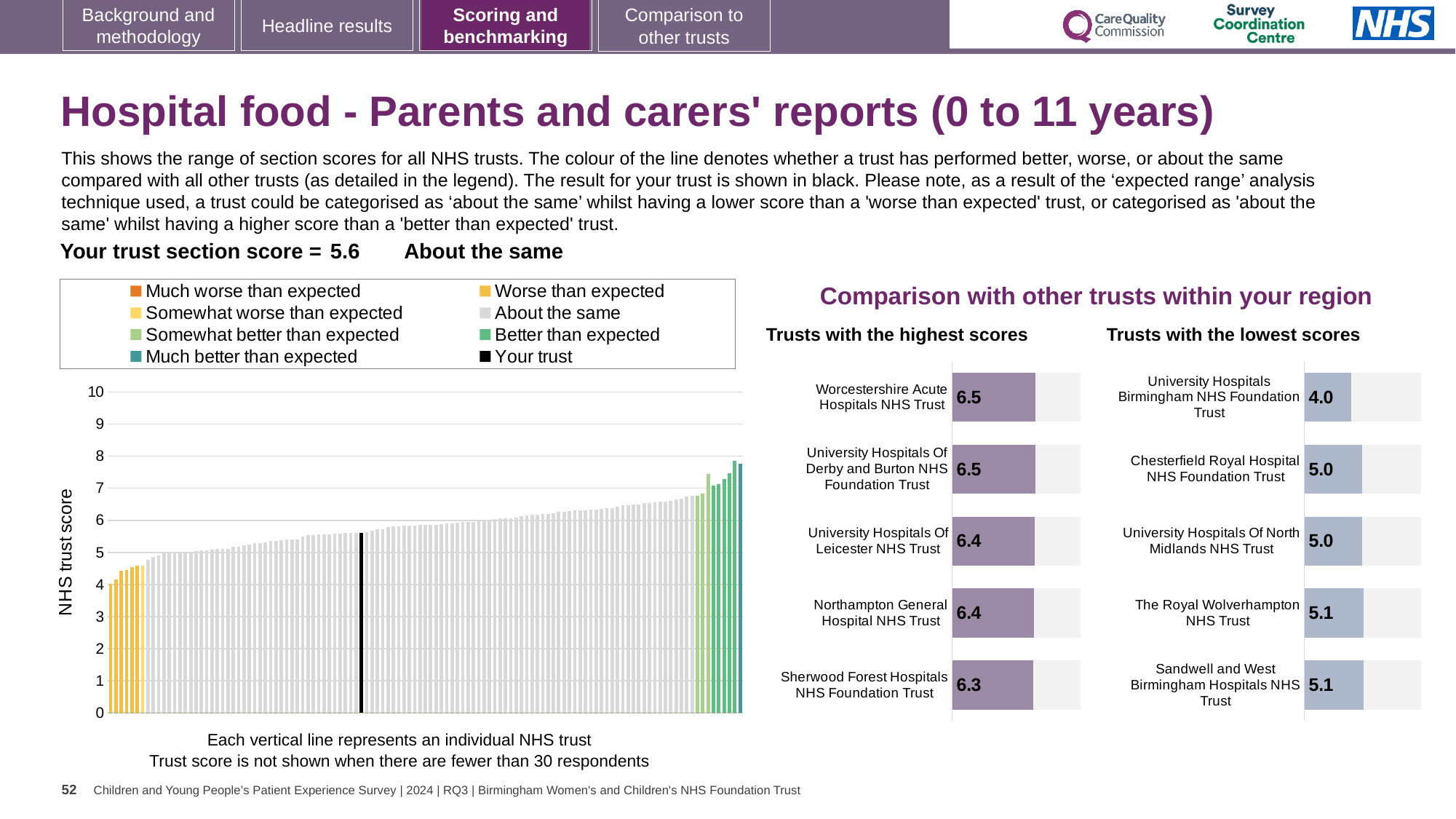
In the 'Trusts with the highest scores' chart, what is the score for Sherwood Forest Hospitals NHS Foundation Trust? 6.3 In the 'Trusts with the lowest scores' chart, what is the difference between the scores of Chesterfield Royal Hospital NHS Foundation Trust and University Hospitals Birmingham NHS Foundation Trust? 1.0 What kind of chart is the large chart on the left showing NHS trust scores? Bar chart In the 'Trusts with the lowest scores' chart, what is the score for The Royal Wolverhampton NHS Trust? 5.1 How many trusts are shown in the 'Trusts with the highest scores' chart? 5 Which has the higher score: University Hospitals Of Leicester NHS Trust in the highest scores chart, or Sandwell and West Birmingham Hospitals NHS Trust in the lowest scores chart? University Hospitals Of Leicester NHS Trust In the 'Trusts with the highest scores' chart, what is the score for Worcestershire Acute Hospitals NHS Trust? 6.5 In the large chart on the left, do the NHS trust scores rise or fall from left to right? Rise In the 'Trusts with the highest scores' chart, which trust has the lowest score? Sherwood Forest Hospitals NHS Foundation Trust In the 'Trusts with the highest scores' chart, what is the difference between the scores of Worcestershire Acute Hospitals NHS Trust and Sherwood Forest Hospitals NHS Foundation Trust? 0.2 In the 'Trusts with the lowest scores' chart, what is the score for University Hospitals Birmingham NHS Foundation Trust? 4.0 In the 'Trusts with the lowest scores' chart, which trust has the lowest score? University Hospitals Birmingham NHS Foundation Trust